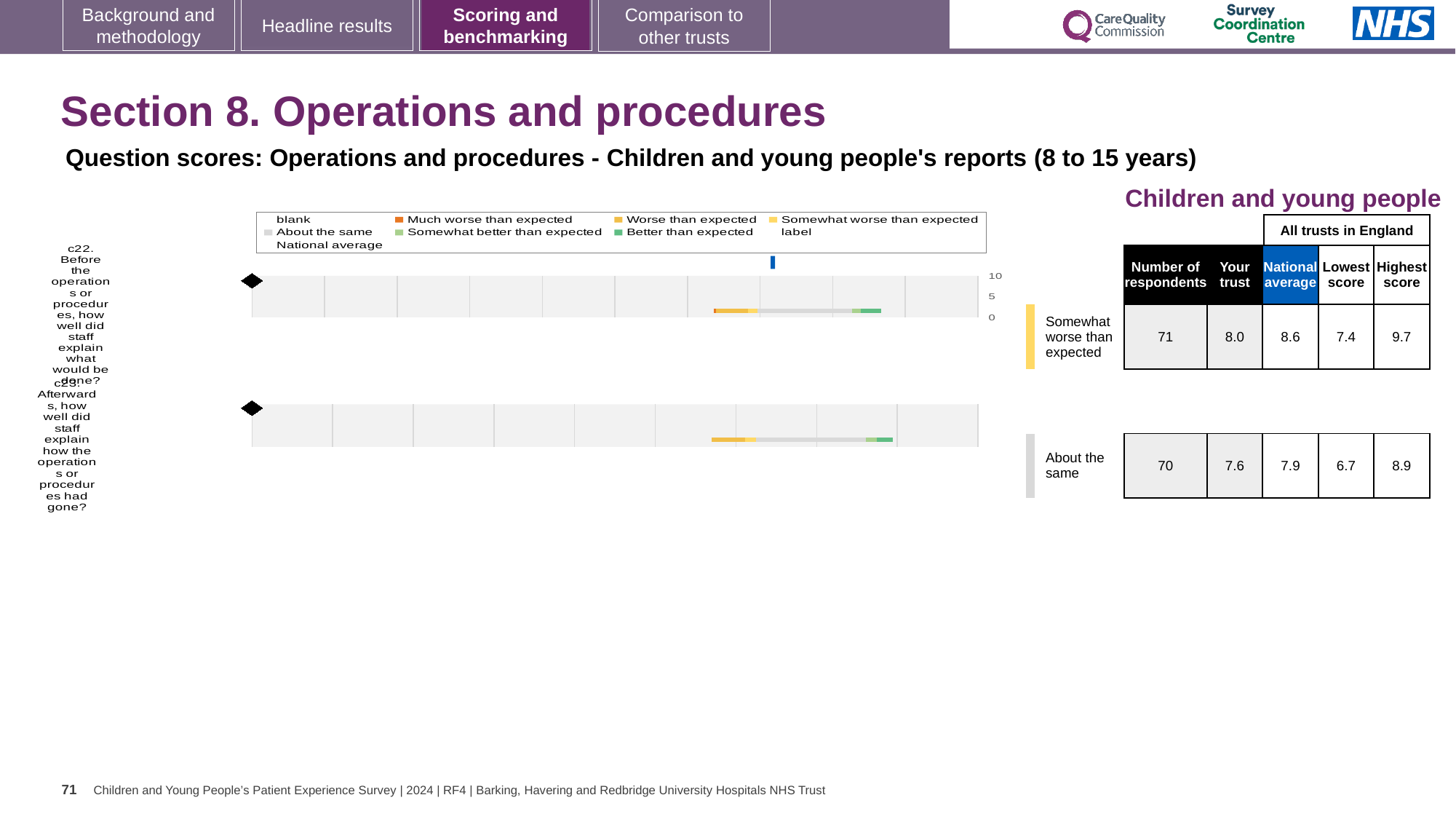
Which benchmarking category is the trust's c22 score placed in? Somewhat worse than expected Which benchmarking category is the trust's c23 score placed in? About the same What is the highest score among all trusts in England for c23? 8.9 Which question has the higher trust score, c22 or c23? c22 How many respondents answered c22? 71 What is the 'Your trust' score for c23 (Afterwards, how well did staff explain how the operations or procedures had gone?)? 7.6 What is the national average for c23? 7.9 What is the 'Your trust' score for c22 (Before the operations or procedures, how well did staff explain what would be done?)? 8.0 What is the national average for c22? 8.6 How many questions (bars) are plotted in the chart? 2 What is the difference between the national average and the trust score for c22? 0.6 What kind of chart is used to show the question scores for c22 and c23? bar chart